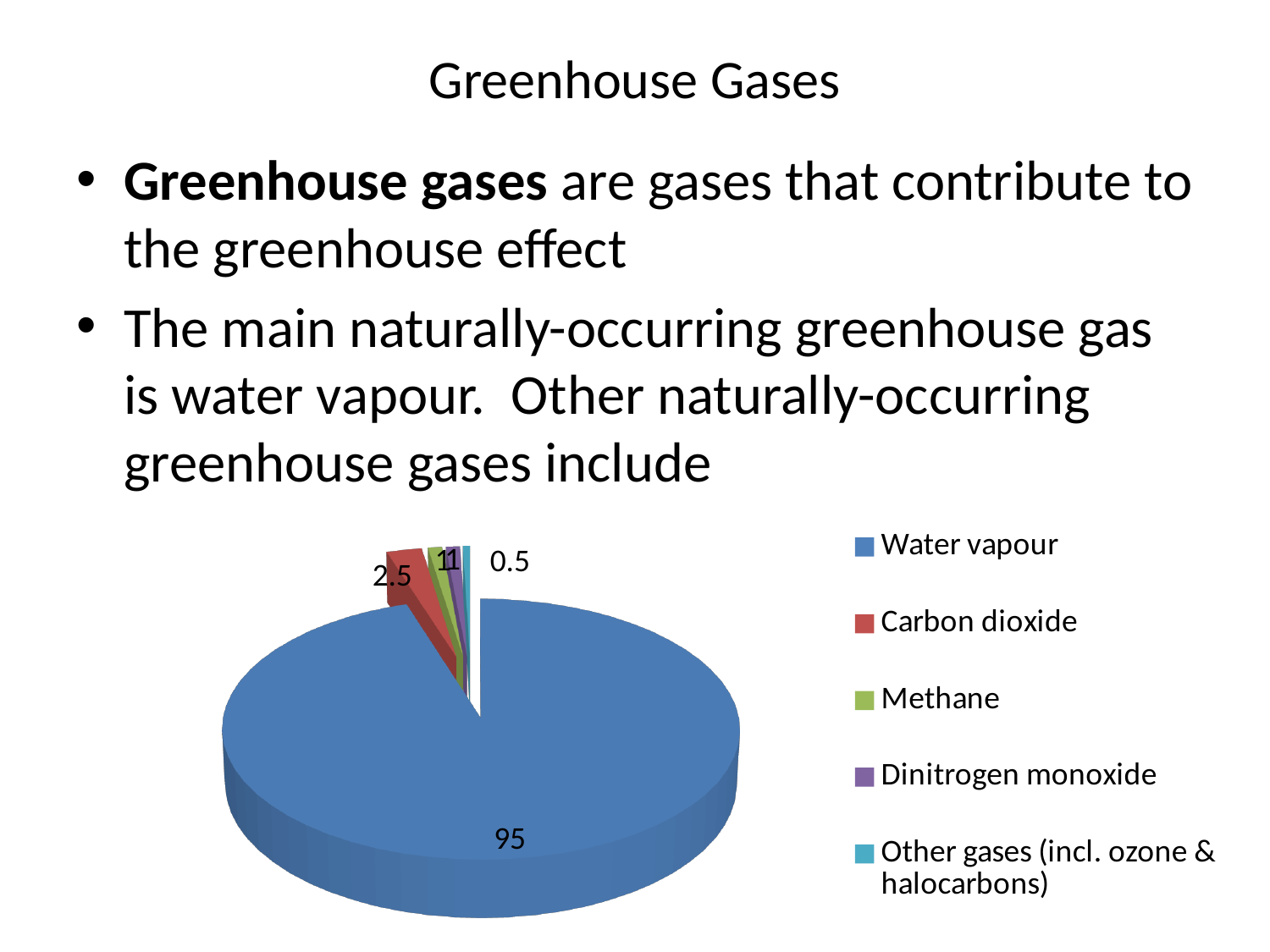
What is the value shown for Other gases (incl. ozone & halocarbons) in the pie chart? 0.5 What is the difference between the values for Water vapour and Carbon dioxide? 92.5 How many categories does the pie chart show? 5 Which category is listed last in the chart legend? Other gases (incl. ozone & halocarbons) What is the value shown for Water vapour in the pie chart? 95 Which category has the largest slice in the pie chart? Water vapour What is the difference between the values for Carbon dioxide and Other gases (incl. ozone & halocarbons)? 2 Which category has the smallest slice in the pie chart? Other gases (incl. ozone & halocarbons) What is the value shown for Carbon dioxide in the pie chart? 2.5 What colour is the Water vapour slice in the pie chart? Blue What kind of chart is shown on the slide? Pie chart Which is larger, the value for Carbon dioxide or the value for Other gases (incl. ozone & halocarbons)? Carbon dioxide